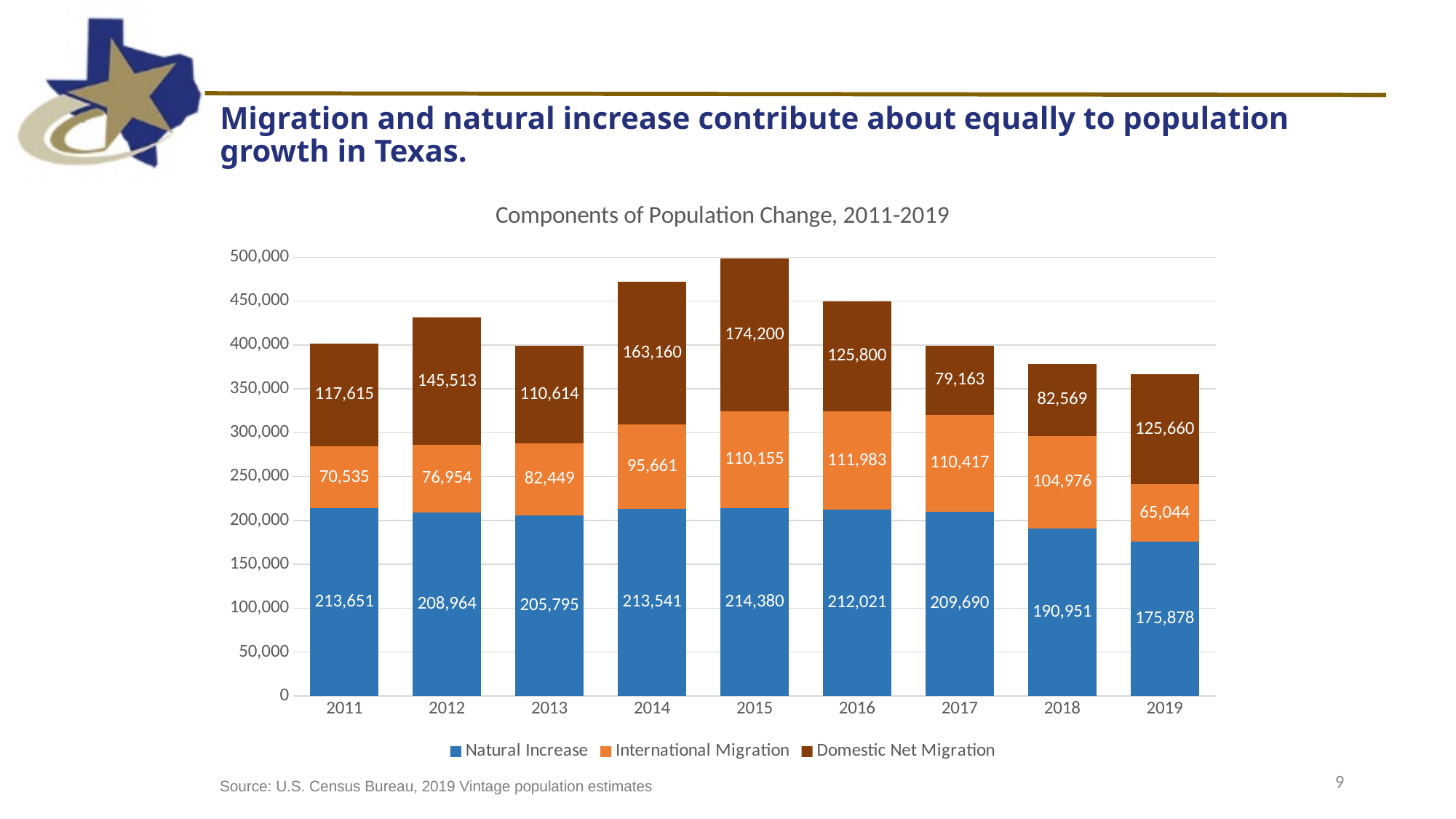
How many series does the legend list? 3 Which year has the highest Domestic Net Migration? 2015 Which year has the lowest International Migration? 2019 What is the total of the stacked bar for 2019? 366,582 What is the Domestic Net Migration value for 2014? 163,160 Which year has the lowest Natural Increase? 2019 What is the Natural Increase value for 2015? 214,380 Which is larger, Domestic Net Migration in 2012 or in 2016? 2012 What kind of chart is shown on the slide? Stacked bar chart What is the difference between Domestic Net Migration in 2015 and 2014? 11,040 What is the International Migration value for 2018? 104,976 How many years are shown on the x axis? 9